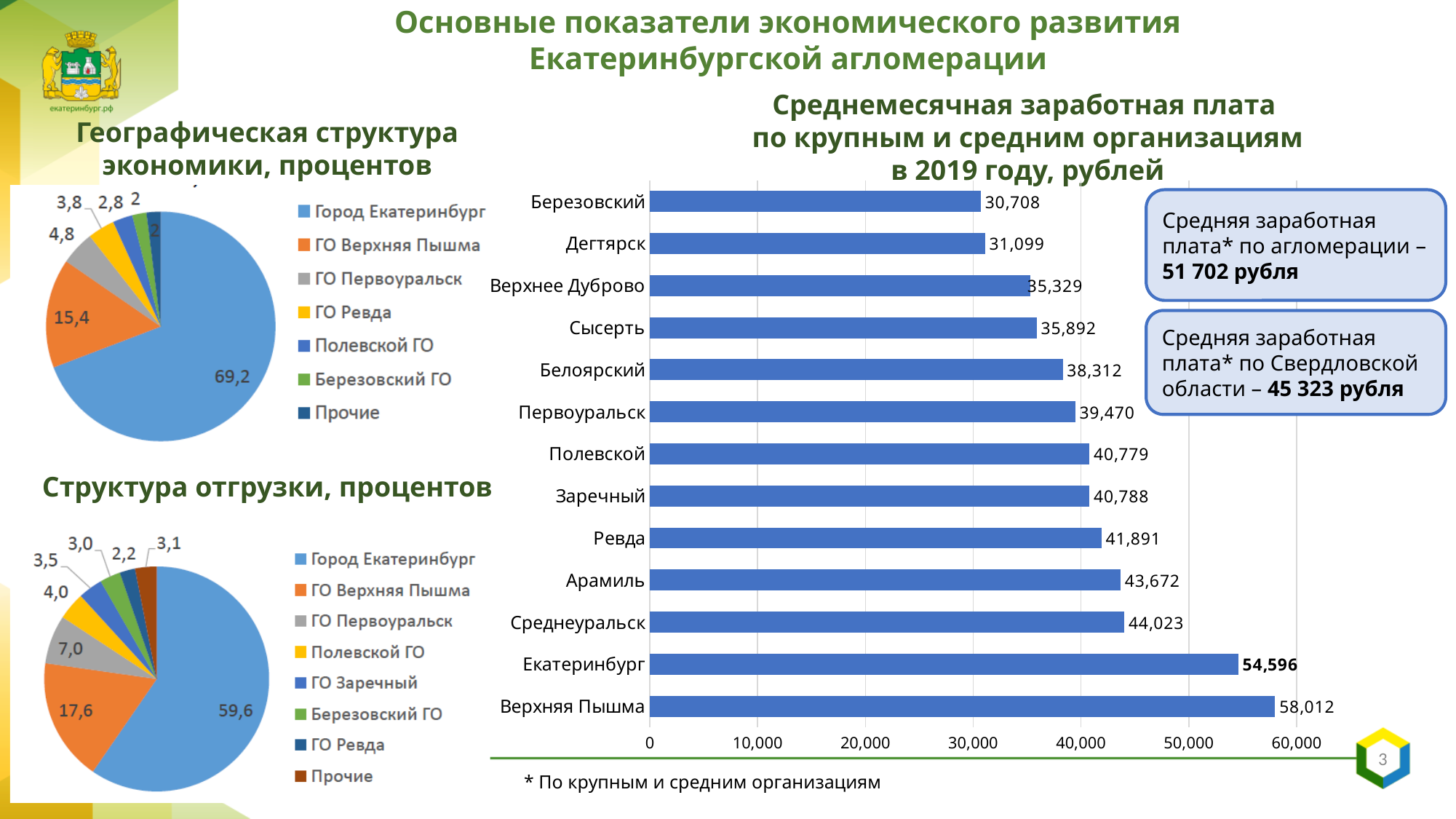
In the bar chart 'Среднемесячная заработная плата', which category has the lowest value? Березовский In the bar chart 'Среднемесячная заработная плата по крупным и средним организациям в 2019 году, рублей', what is the value for Екатеринбург? 54,596 In the bar chart 'Среднемесячная заработная плата', what is the value for Первоуральск? 39,470 In the bar chart 'Среднемесячная заработная плата', which category has the highest value? Верхняя Пышма What kind of chart is 'Среднемесячная заработная плата по крупным и средним организациям в 2019 году, рублей'? bar chart In the pie chart 'Структура отгрузки, процентов', what is the value for ГО Верхняя Пышма? 17,6 In the bar chart 'Среднемесячная заработная плата', what is the difference between the values for Верхняя Пышма and Екатеринбург? 3,416 In the bar chart 'Среднемесячная заработная плата', which is larger: the value for Арамиль or the value for Ревда? Арамиль In the bar chart 'Среднемесячная заработная плата', is the value for Сысерть greater or less than 40,000? less How many entries does the legend of the pie chart 'Структура отгрузки, процентов' list? 8 How many categories are shown in the bar chart 'Среднемесячная заработная плата'? 13 In the pie chart 'Географическая структура экономики, процентов', what is the share for Город Екатеринбург? 69,2